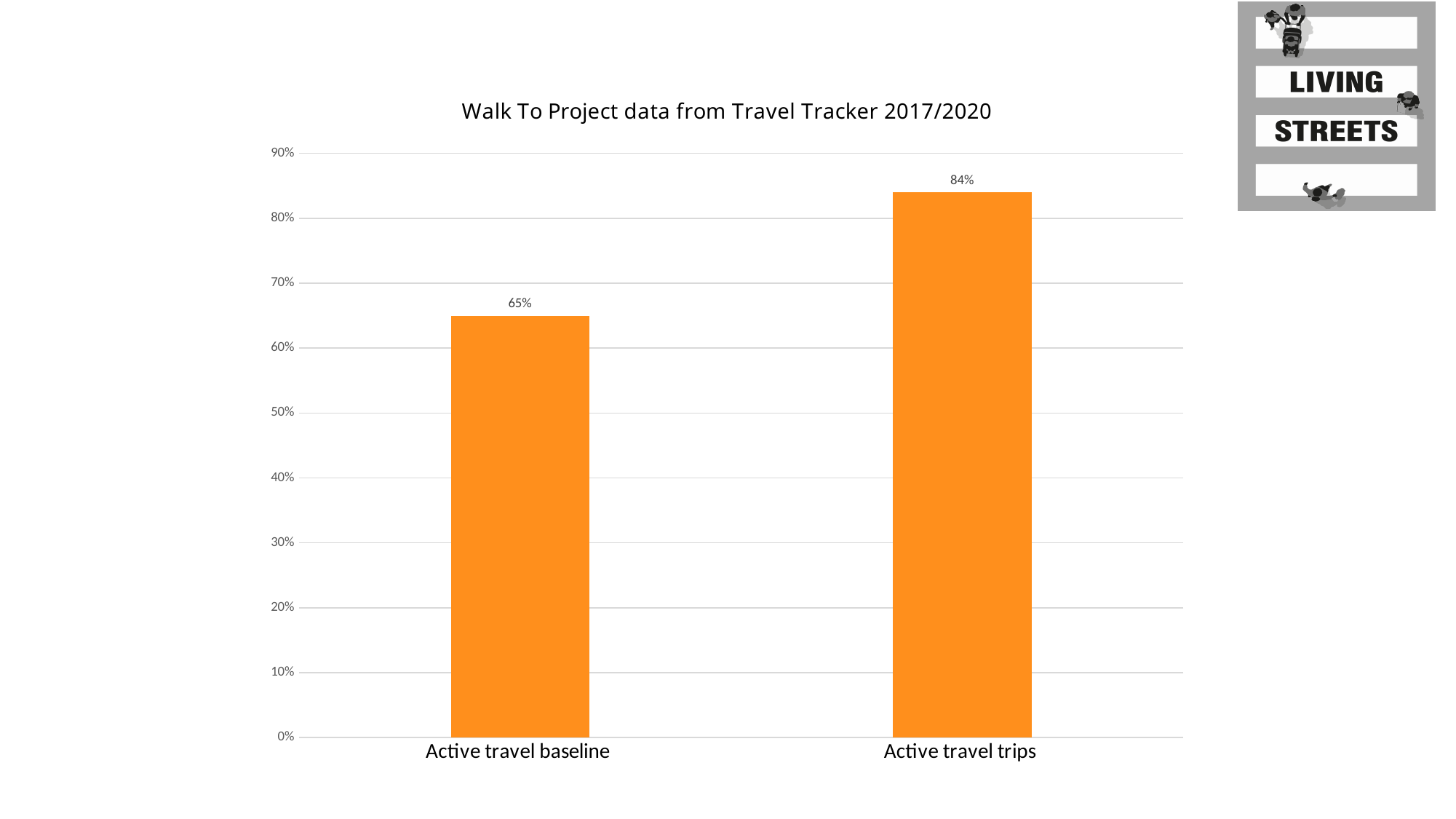
Is the value for Active travel trips greater or less than 80%? greater What is the title of the chart? Walk To Project data from Travel Tracker 2017/2020 Do the values rise or fall from Active travel baseline to Active travel trips? Rise Which is larger, the value for Active travel baseline or the value for Active travel trips? Active travel trips Which category has the highest value? Active travel trips Which category has the lowest value? Active travel baseline What kind of chart is shown on the slide? Bar chart What is the difference between the values for Active travel trips and Active travel baseline? 19% What is the value for Active travel baseline? 65% What is the value for Active travel trips? 84% How many categories are shown on the chart? 2 Is the value for Active travel baseline greater or less than 70%? less